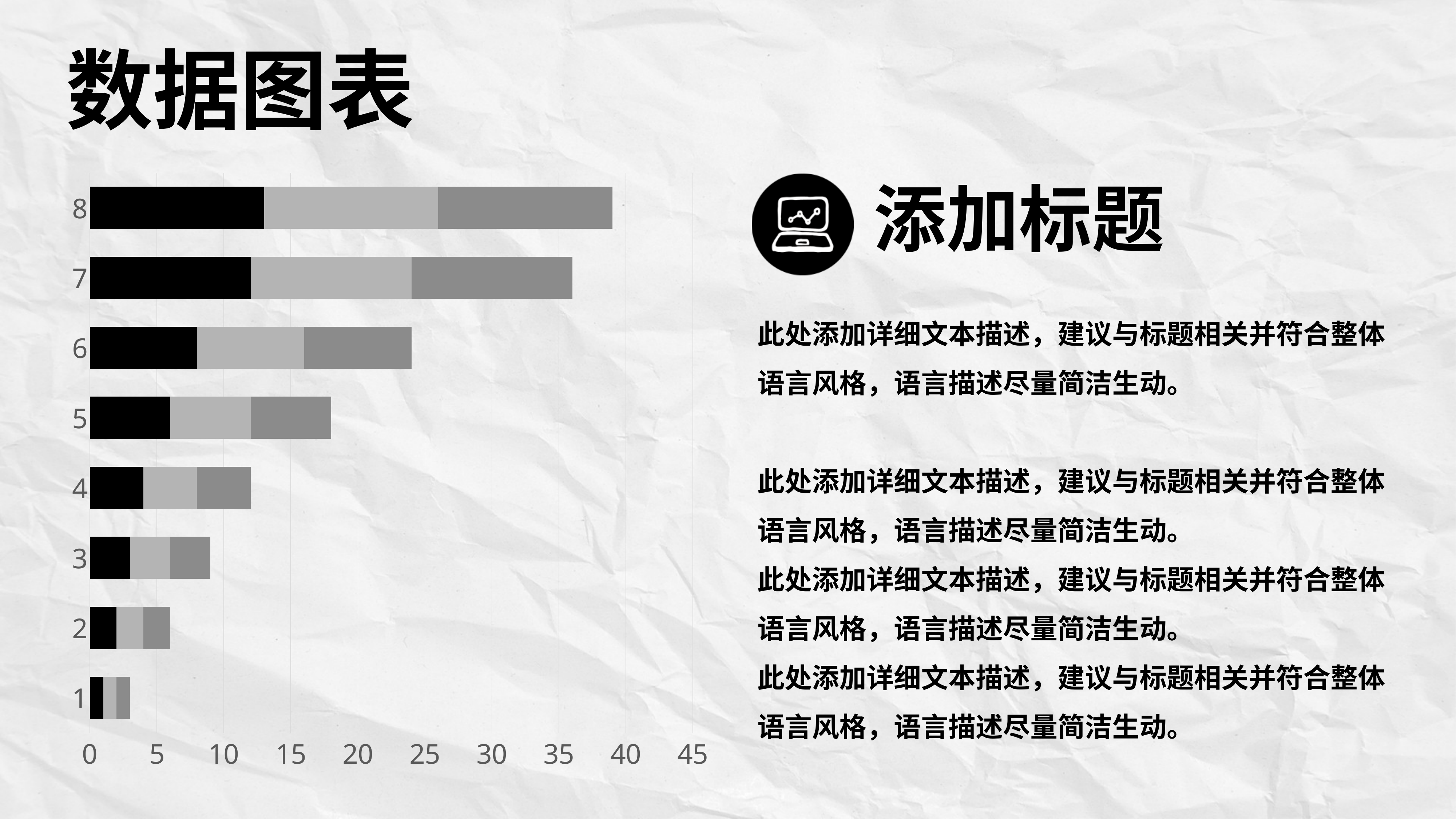
How many coloured segments make up each stacked bar? 3 How many categories are shown on the chart's vertical axis? 8 Is the total bar for category 6 greater or less than 25? less Is the total bar for category 1 greater or less than 5? less Is the total bar for category 8 greater or less than 35? greater Which category has the shortest total bar? 1 Which has the longer total bar, category 7 or category 6? 7 Which category has the longest total bar? 8 What kind of chart is shown on the slide? bar chart Do the total bar lengths rise or fall going from category 1 up to category 8? rise